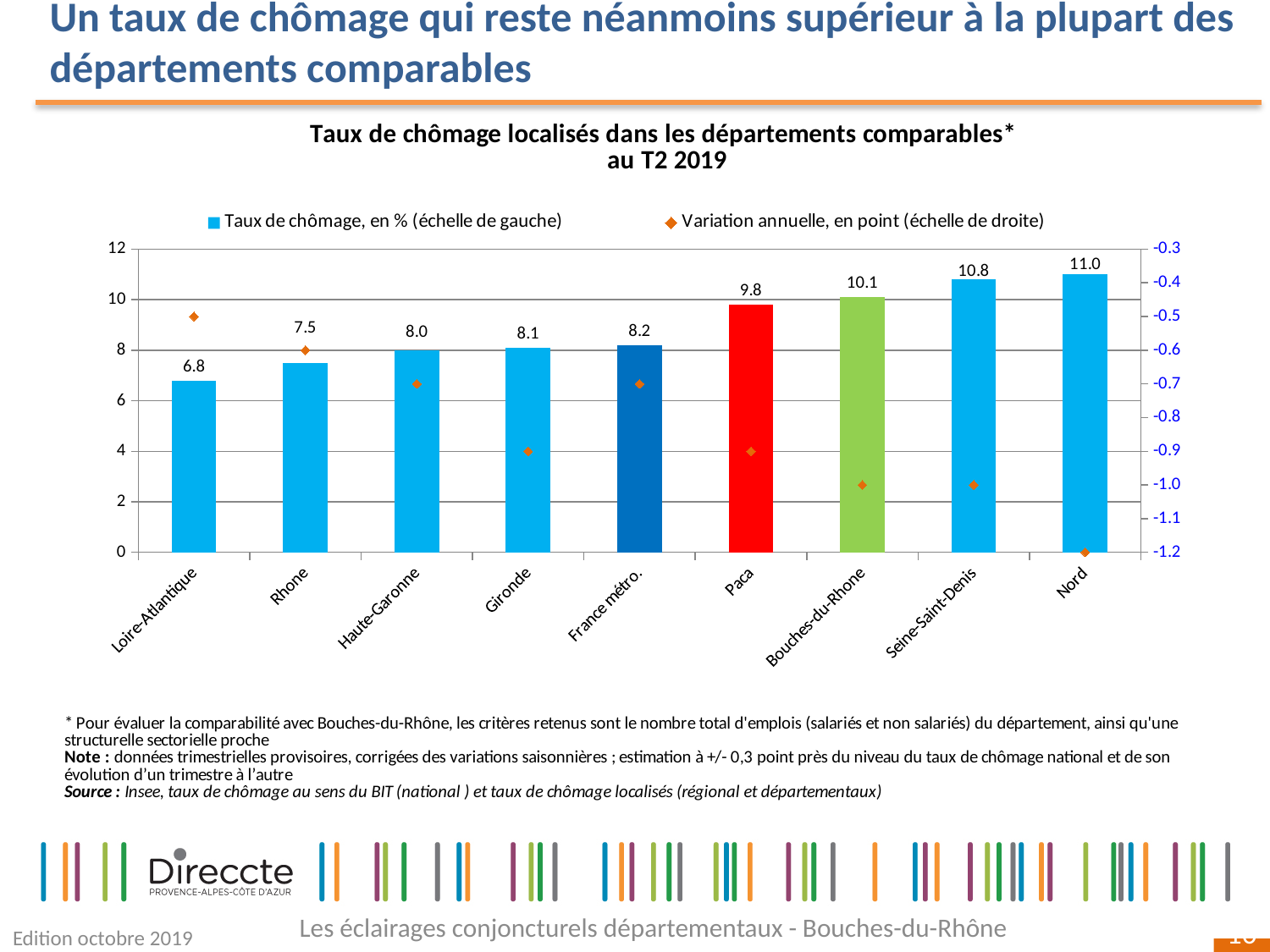
What colour is the bar for Paca? Red What is the difference between the unemployment rate of Bouches-du-Rhone and that of France métro.? 1.9 How many series does the chart legend list? 2 Which has a higher unemployment rate, Paca or Seine-Saint-Denis? Seine-Saint-Denis Which department has the highest unemployment rate on the chart? Nord Which department has the lowest unemployment rate on the chart? Loire-Atlantique Is the annual variation (Variation annuelle) for Nord greater or less than -1.0 points? less What is the unemployment rate shown for France métro.? 8.2 What is the unemployment rate (Taux de chômage) shown for Bouches-du-Rhone? 10.1 Is the annual variation for Loire-Atlantique greater or less than -0.8 points? greater What is the unemployment rate shown for Loire-Atlantique? 6.8 How many departments or areas are shown on the x axis of the chart? 9